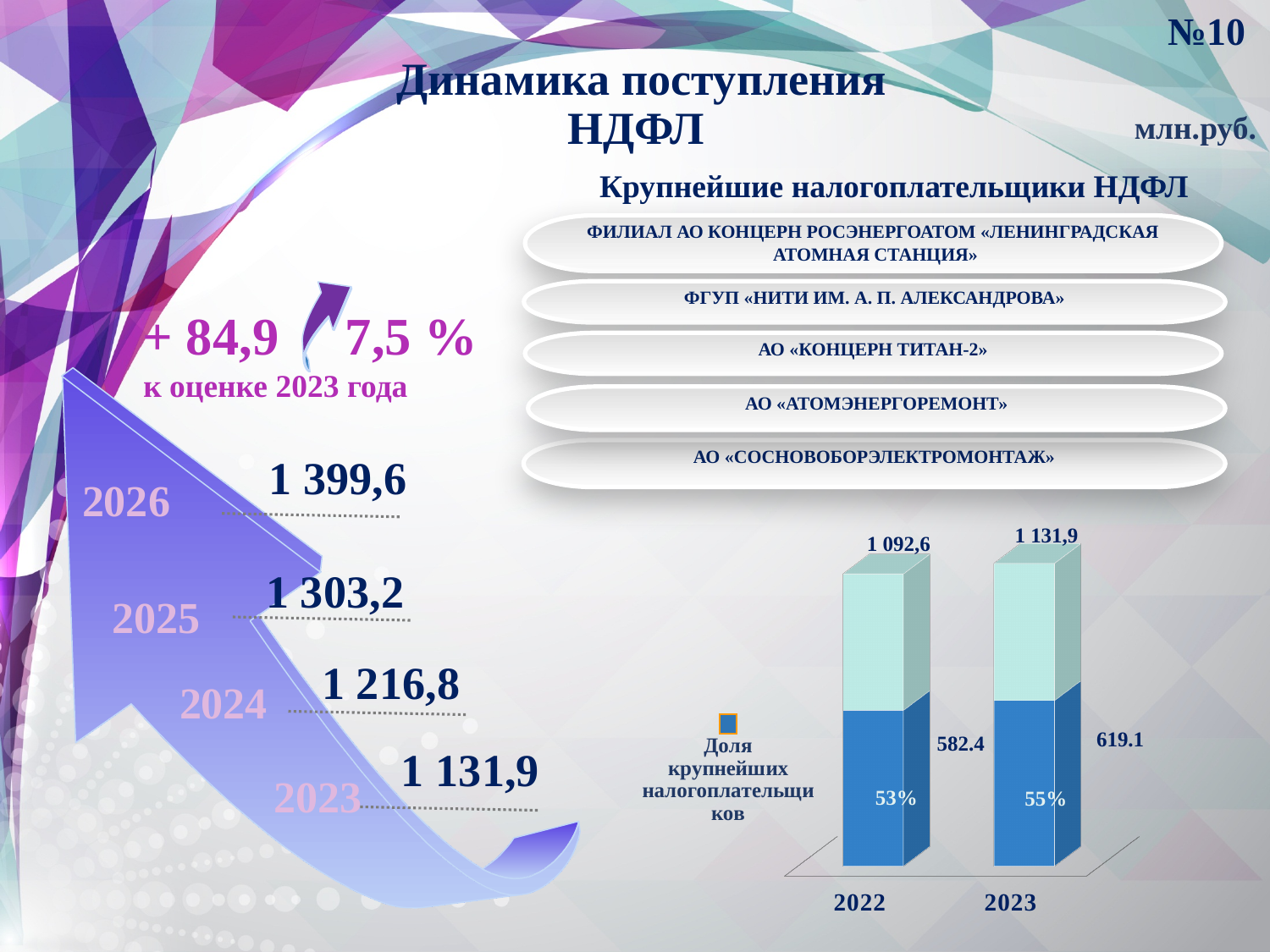
In the bar chart, what is the value of the largest taxpayers' share (dark blue segment) for 2023? 619.1 In the bar chart, what is the total value labelled above the 2023 bar? 1 131,9 In the bar chart, what percentage is printed on the dark blue segment of the 2022 bar? 53% In the bar chart, what is the total value labelled above the 2022 bar? 1 092,6 In the bar chart, what percentage is printed on the dark blue segment of the 2023 bar? 55% In the bar chart, what is the value of the largest taxpayers' share (dark blue segment) for 2022? 582.4 What kind of chart is shown at the bottom right of the slide? bar chart In the bar chart, do the total values rise or fall from 2022 to 2023? rise In the bar chart, which year has the higher total value, 2022 or 2023? 2023 In the bar chart, by how much does the largest taxpayers' value for 2023 exceed that for 2022? 36.7 What is the legend entry shown next to the bar chart? Доля крупнейших налогоплательщиков How many years are shown on the x axis of the bar chart? 2